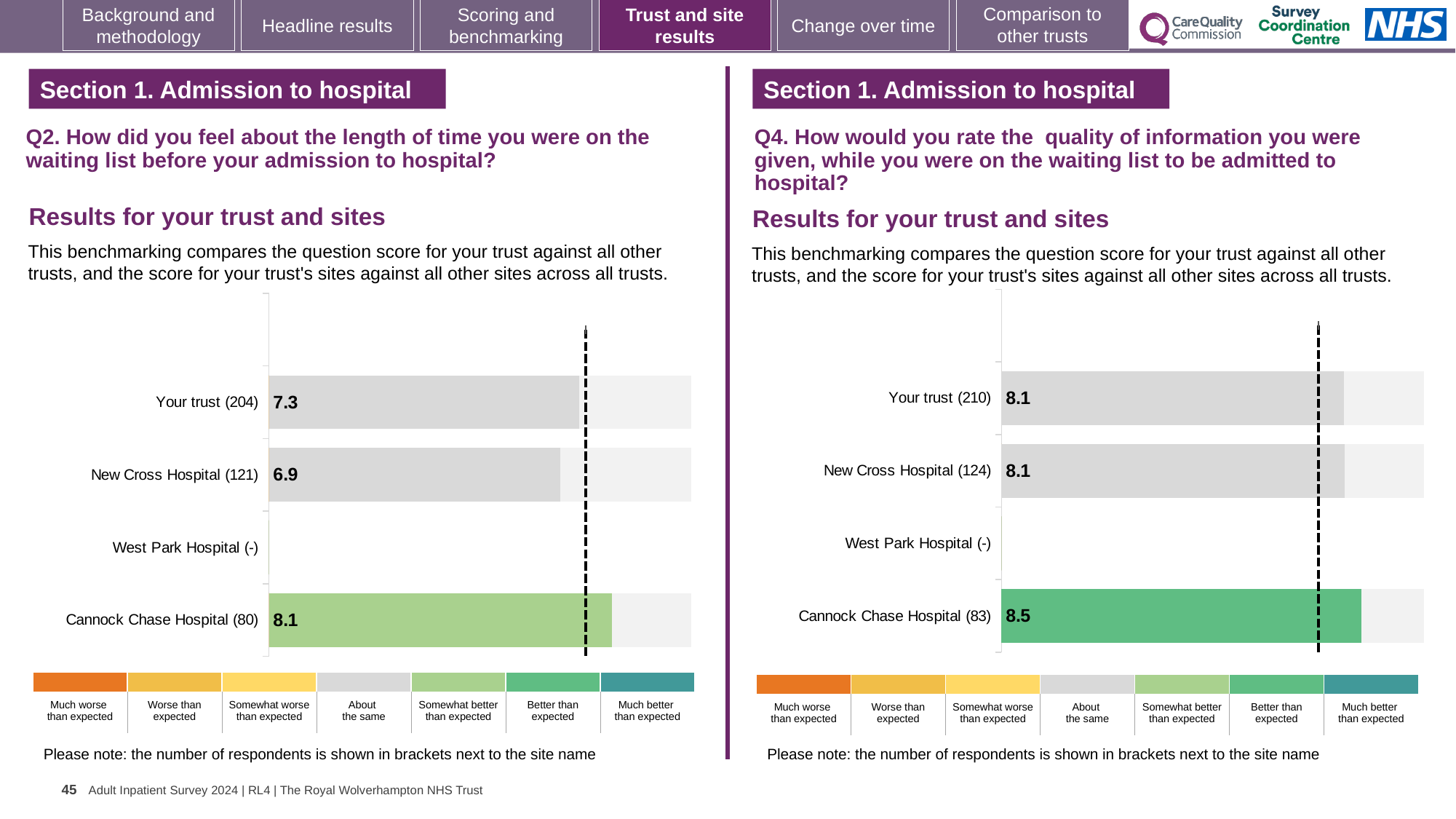
In the right chart (Q4), what is the difference between the scores for Cannock Chase Hospital and Your trust? 0.4 In the left chart (Q2), which has the larger score, Your trust or New Cross Hospital? Your trust In the left chart (Q2), what is the score for New Cross Hospital? 6.9 In the left chart (Q2, length of time on the waiting list), what is the score for Your trust? 7.3 In the left chart (Q2), what is the difference between the scores for Cannock Chase Hospital and New Cross Hospital? 1.2 In the right chart (Q4), how many respondents are shown in brackets for Your trust? 210 In the right chart (Q4), what is the score for New Cross Hospital? 8.1 In the left chart (Q2), which site has the highest score? Cannock Chase Hospital In the right chart (Q4, quality of information while on the waiting list), what is the score for Cannock Chase Hospital? 8.5 How many site/trust rows are listed in the left chart (Q2)? 4 In the left chart (Q2), what is the score for Cannock Chase Hospital? 8.1 What type of chart is used on this slide to show the scores? Bar chart